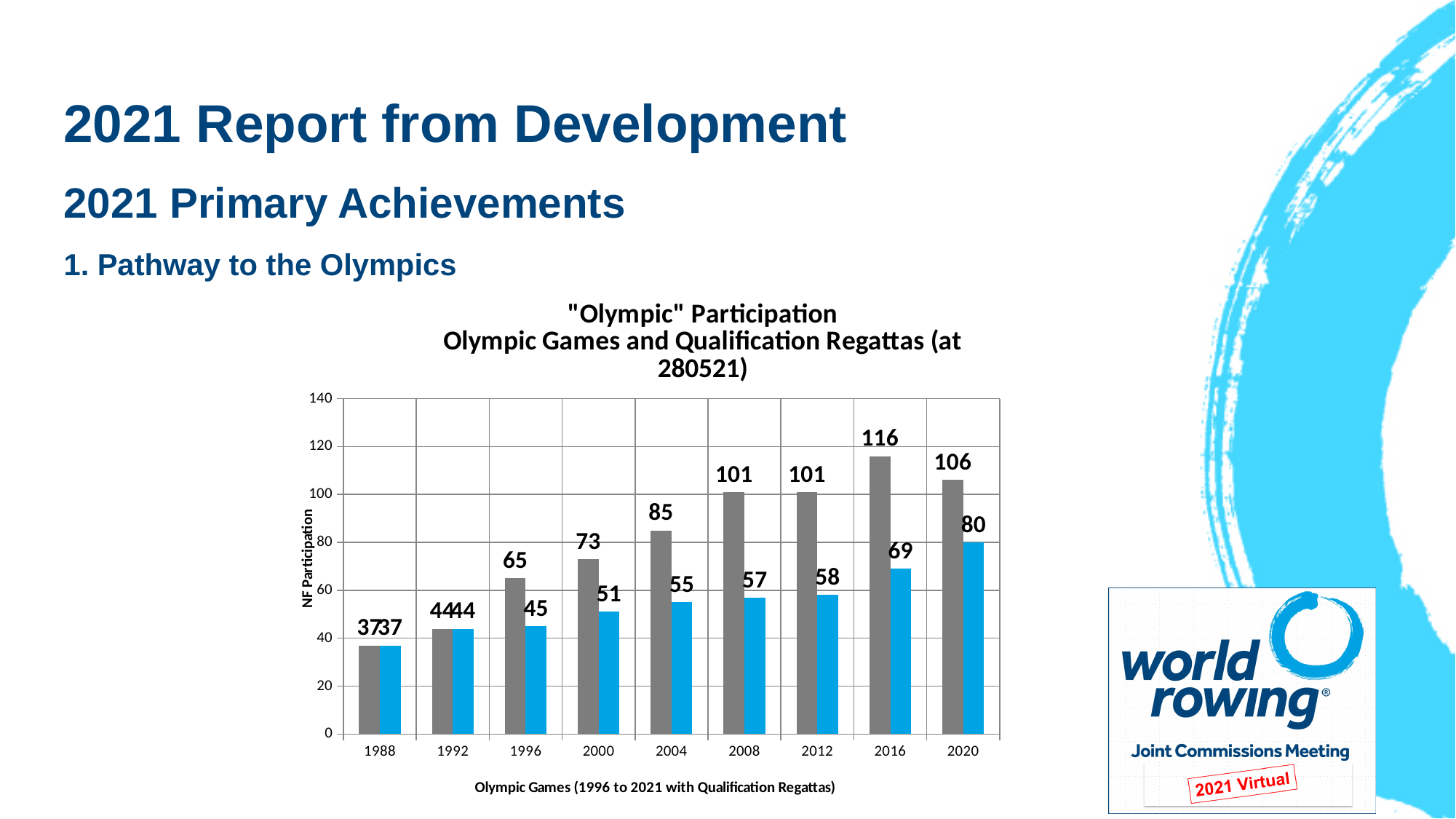
What type of chart is shown on the slide? bar chart Do the blue bar values generally rise or fall from 1988 to 2020? rise What is the value of the grey bar for 2016? 116 How many years are shown on the x axis? 9 Which is larger, the grey bar for 2020 or the grey bar for 2016? 2016 What is the value of the blue bar for 2012? 58 What is the value of the blue bar for 2020? 80 What is the value of the grey bar for 2004? 85 Which year has the lowest blue bar? 1988 What is the difference between the grey bar and the blue bar for 2016? 47 What is the label of the y axis? NF Participation Which year has the highest grey bar? 2016